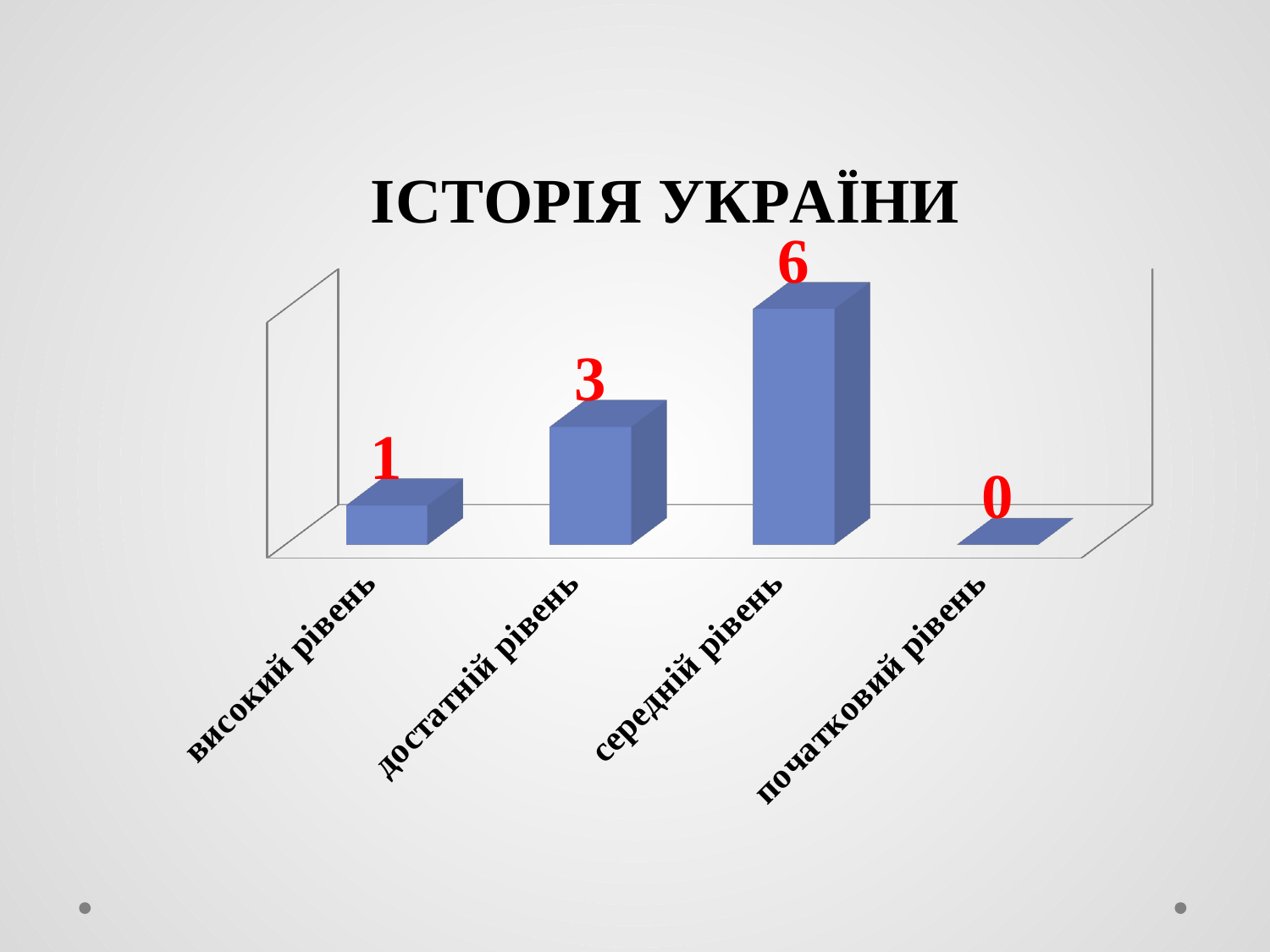
Which category has the highest value? середній рівень What is the value for високий рівень? 1 What is the difference between the values for достатній рівень and високий рівень? 2 What kind of chart is shown on the slide? bar chart What is the difference between the values for середній рівень and достатній рівень? 3 How many categories are shown on the chart? 4 What is the value for достатній рівень? 3 What is the value for середній рівень? 6 What is the value for початковий рівень? 0 What is the title of the chart? ІСТОРІЯ УКРАЇНИ Which category has the lowest value? початковий рівень Which is larger, the value for високий рівень or the value for достатній рівень? достатній рівень